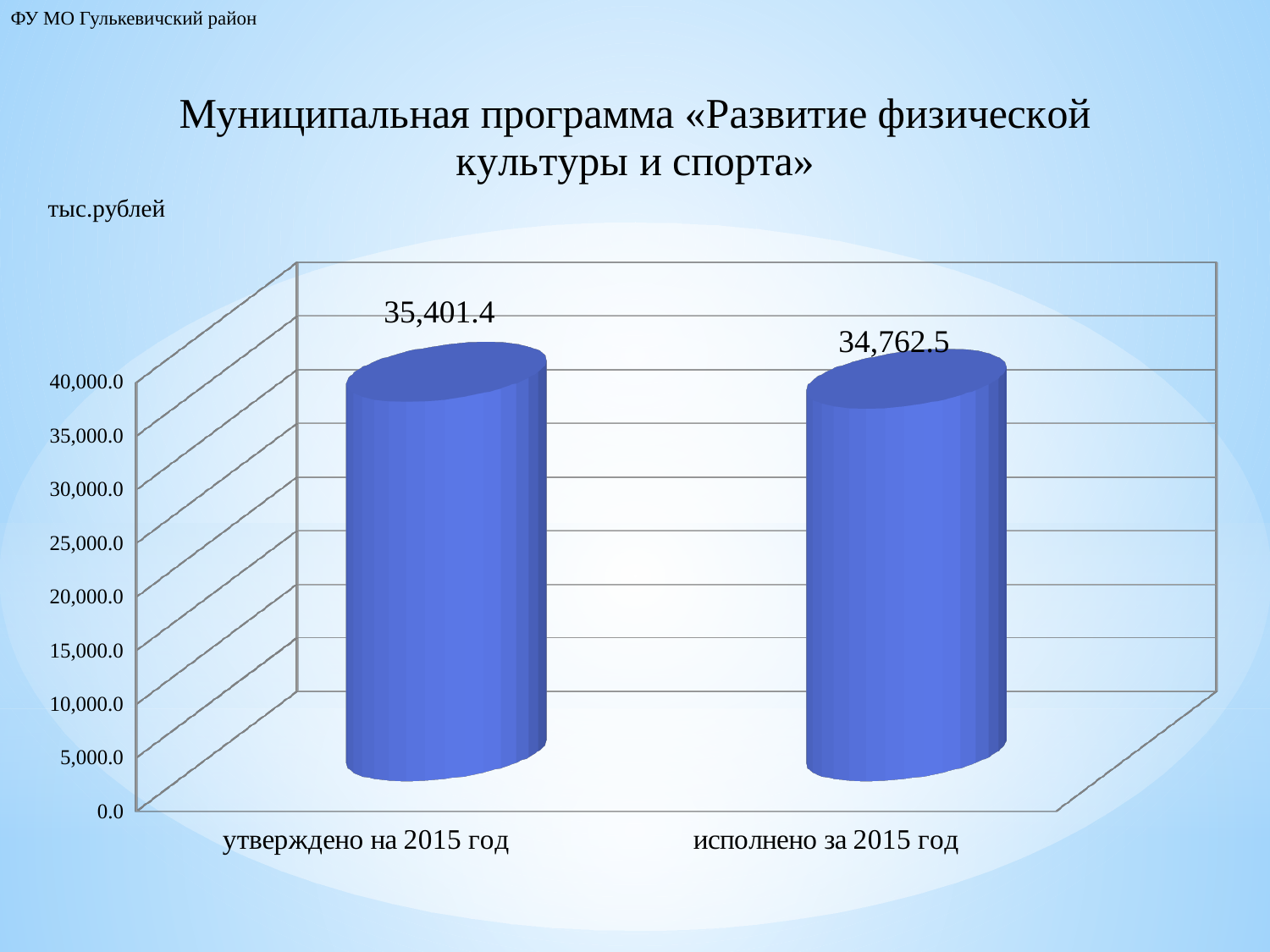
Which category has the higher value? утверждено на 2015 год What unit of measurement is indicated for the chart values? тыс.рублей What is the value for «утверждено на 2015 год»? 35,401.4 Is the value for «исполнено за 2015 год» larger or smaller than the value for «утверждено на 2015 год»? smaller Which category has the lower value? исполнено за 2015 год What kind of chart is shown on the slide? bar chart How many categories are shown on the chart? 2 What is the difference between the value for «утверждено на 2015 год» and the value for «исполнено за 2015 год»? 638.9 What is the value for «исполнено за 2015 год»? 34,762.5 Is the value for «исполнено за 2015 год» greater or less than 30,000.0? greater What is the title of the chart? Муниципальная программа «Развитие физической культуры и спорта» Is the value for «утверждено на 2015 год» greater or less than 40,000.0? less